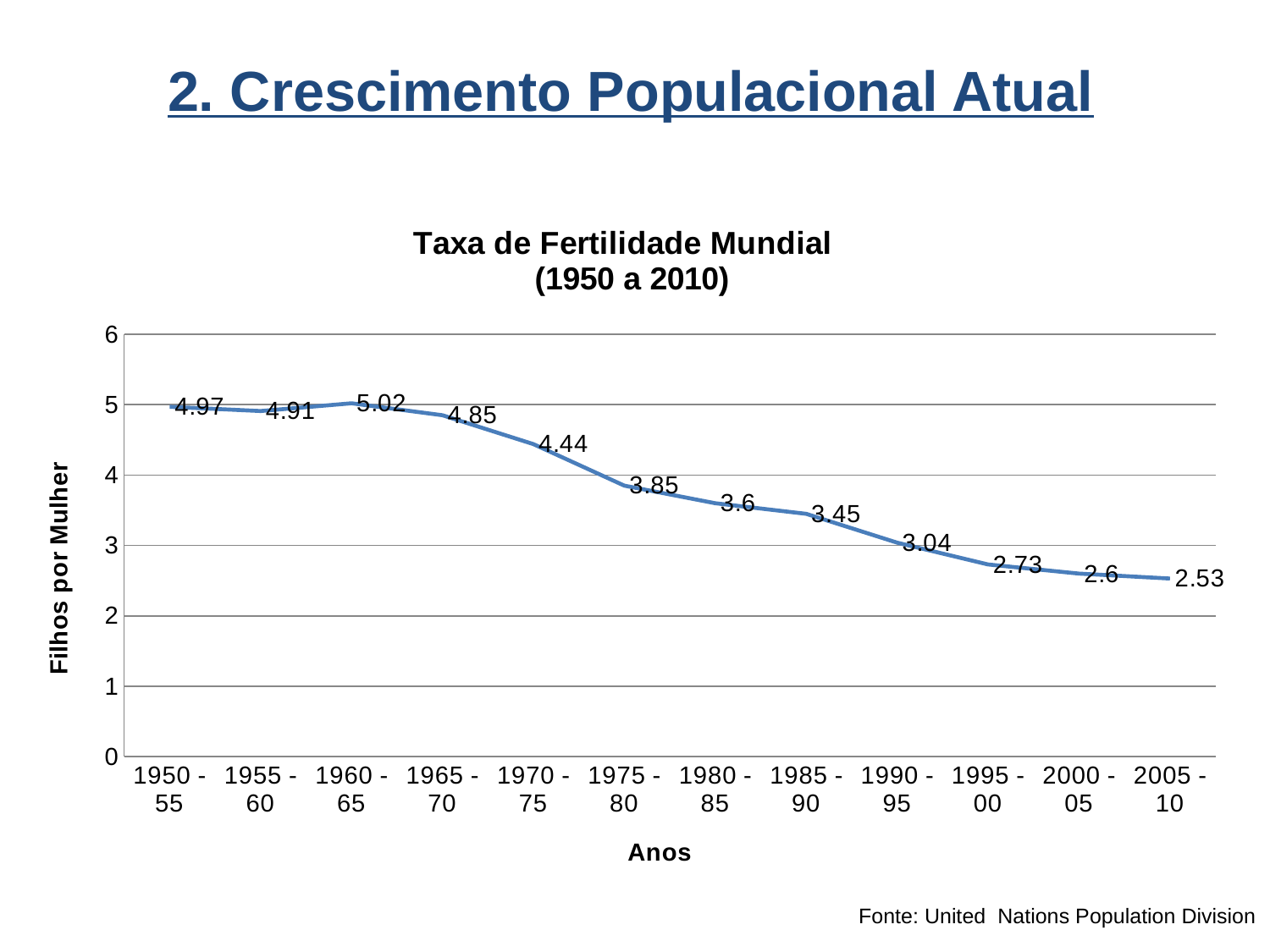
What is the value shown for 1975 - 80? 3.85 What is the world fertility rate for 1950 - 55? 4.97 Is the value for 1990 - 95 greater or less than 4? less How many periods are plotted on the x axis? 12 Which period has the highest fertility rate? 1960 - 65 Which is larger, the value for 1970 - 75 or the value for 1980 - 85? 1970 - 75 What is the difference between the values for 1950 - 55 and 2005 - 10? 2.44 What is the value shown for 2005 - 10? 2.53 Do the values generally rise or fall from 1950 - 55 to 2005 - 10? fall What kind of chart is shown? line chart What is the label of the y axis? Filhos por Mulher Which period has the lowest fertility rate? 2005 - 10